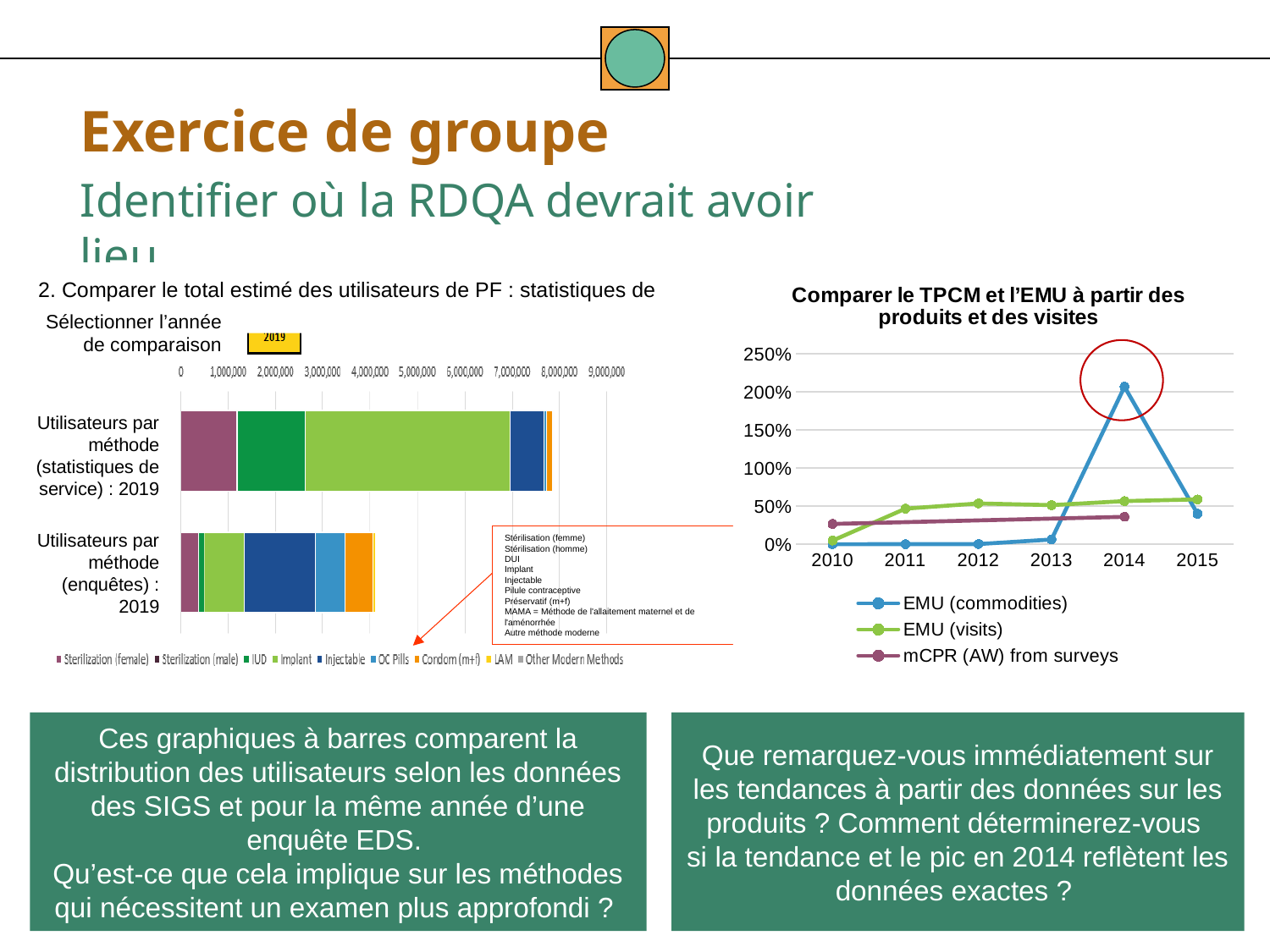
What kind of chart is the chart titled 'Comparer le TPCM et l'EMU à partir des produits et des visites'? Line chart In the chart 'Comparer le TPCM et l'EMU à partir des produits et des visites', how many years are shown on the x axis? 6 In the bar chart on the left showing 'Utilisateurs par méthode', how many series does the legend list? 9 What kind of chart is the chart on the left showing 'Utilisateurs par méthode'? Bar chart In the chart 'Comparer le TPCM et l'EMU à partir des produits et des visites', is the value for EMU (commodities) in 2014 greater or less than 200%? greater In the chart 'Comparer le TPCM et l'EMU à partir des produits et des visites', does mCPR (AW) from surveys rise or fall from 2010 to 2014? Rise In the chart 'Comparer le TPCM et l'EMU à partir des produits et des visites', how many series does the legend list? 3 In the chart 'Comparer le TPCM et l'EMU à partir des produits et des visites', is the value for EMU (commodities) in 2011 greater or less than 50%? less In the bar chart on the left showing 'Utilisateurs par méthode', is the total of the 'Utilisateurs par méthode (enquêtes) : 2019' bar greater or less than 5,000,000? less In the chart 'Comparer le TPCM et l'EMU à partir des produits et des visites', in which year does EMU (commodities) reach its highest value? 2014